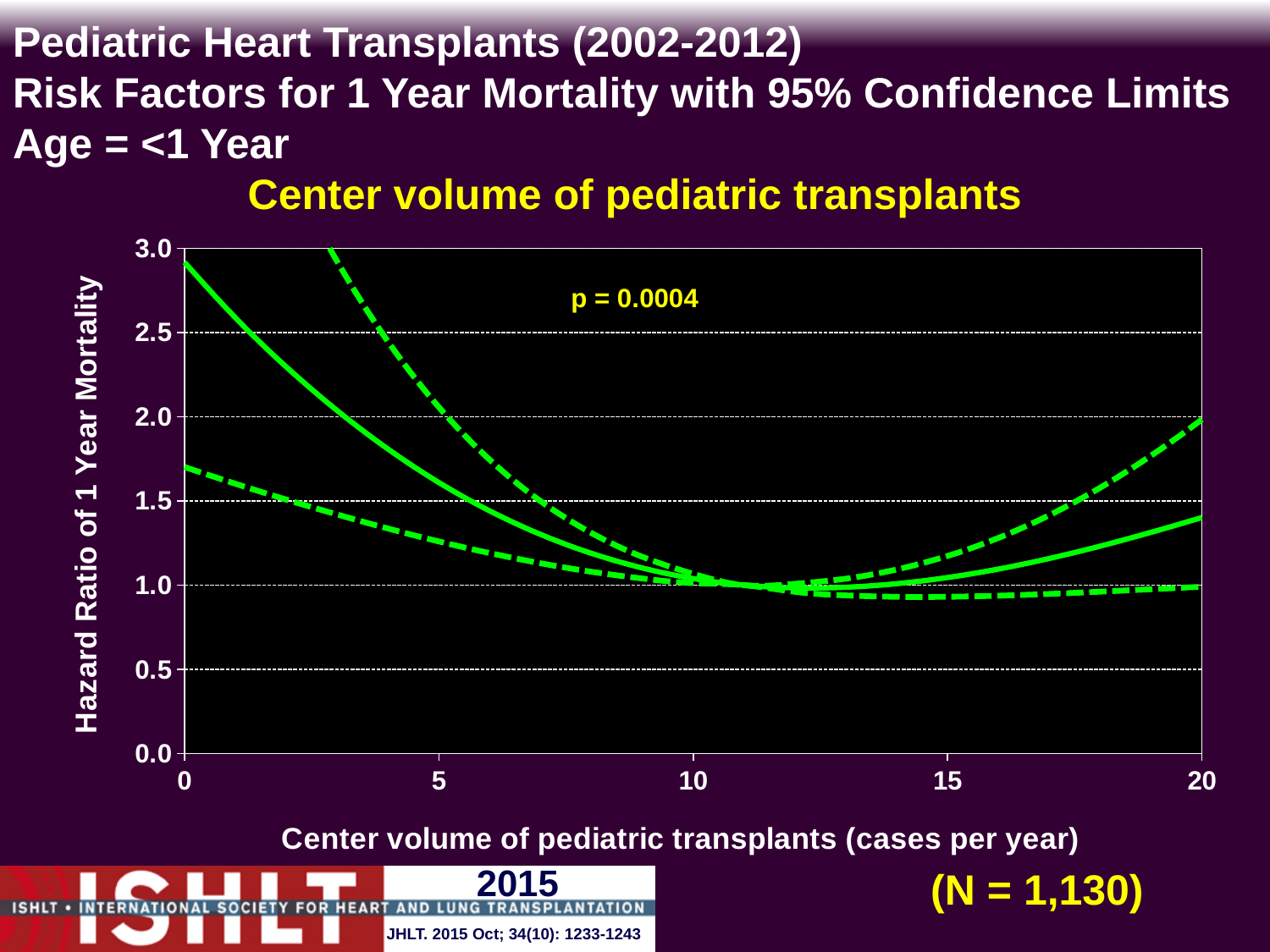
Is the hazard ratio on the solid line at a center volume of 0 cases per year greater or less than 2.5? greater What kind of chart is shown on the slide? line chart Does the solid hazard ratio line rise or fall as center volume increases from 0 to 10 cases per year? fall Does the solid hazard ratio line rise or fall as center volume increases from 15 to 20 cases per year? rise Is the lower dashed confidence limit at a center volume of 0 cases per year greater or less than 1.5? greater Is the lower dashed confidence limit at a center volume of 15 cases per year greater or less than 1.0? less What is the title of the chart? Center volume of pediatric transplants What is the maximum value shown on the y axis of the chart? 3.0 What p-value is printed on the chart? p = 0.0004 How many lines are plotted on the chart? 3